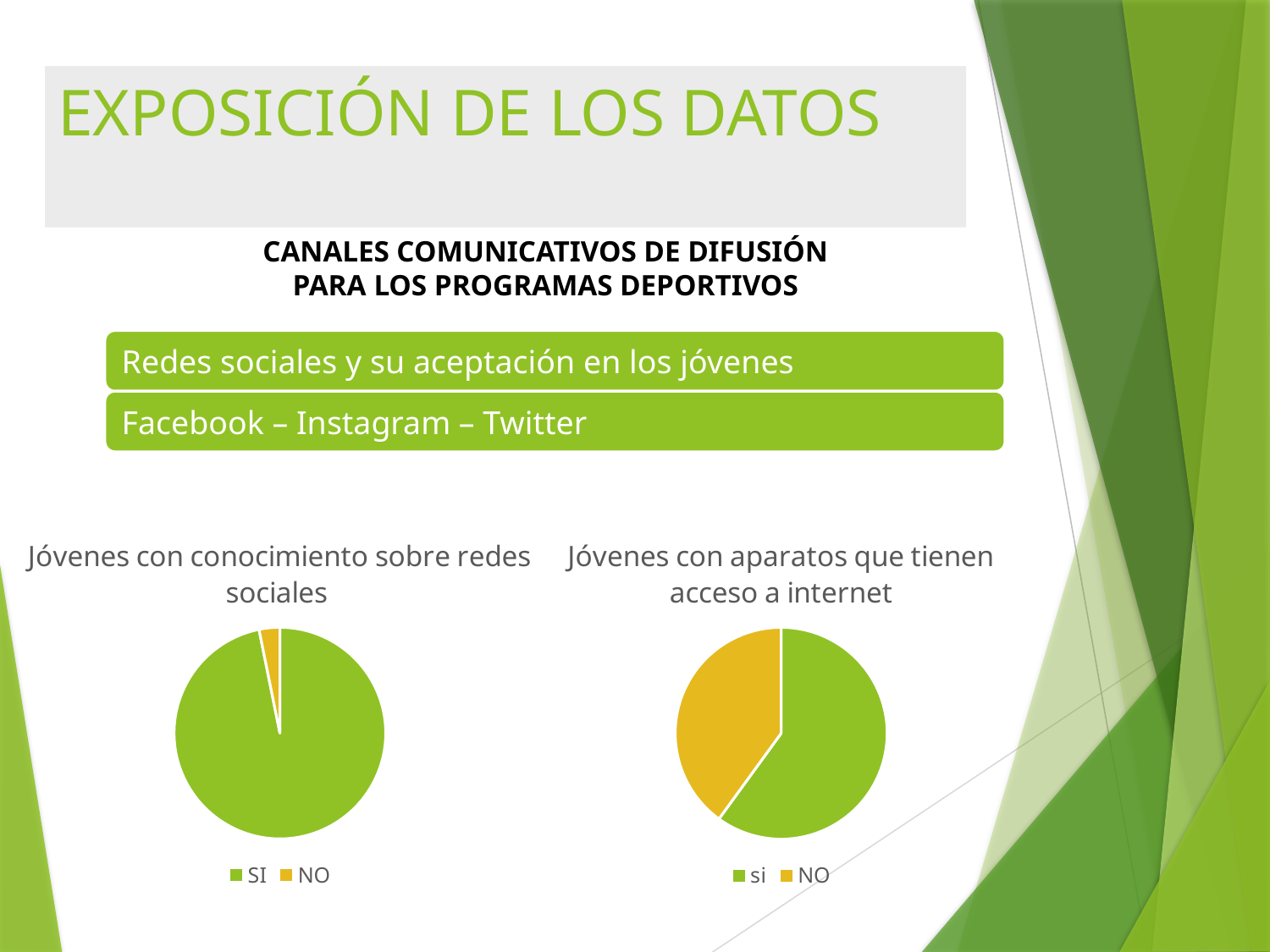
What is the title of the pie chart on the left of the slide? Jóvenes con conocimiento sobre redes sociales In the chart titled "Jóvenes con aparatos que tienen acceso a internet", which category has the smallest slice? NO In the chart titled "Jóvenes con conocimiento sobre redes sociales", which category has the smallest slice? NO In the chart titled "Jóvenes con aparatos que tienen acceso a internet", which category has the largest slice? si In the chart titled "Jóvenes con conocimiento sobre redes sociales", which category has the largest slice? SI In the chart titled "Jóvenes con aparatos que tienen acceso a internet", how many slices does the pie have? 2 In the chart titled "Jóvenes con conocimiento sobre redes sociales", how many entries does the legend list? 2 In the chart titled "Jóvenes con conocimiento sobre redes sociales", how many slices does the pie have? 2 In the chart titled "Jóvenes con aparatos que tienen acceso a internet", what colour is the NO slice? yellow In the chart titled "Jóvenes con aparatos que tienen acceso a internet", which slice is larger, si or NO? si What kind of chart is the chart titled "Jóvenes con aparatos que tienen acceso a internet"? pie chart What kind of chart is the chart titled "Jóvenes con conocimiento sobre redes sociales"? pie chart